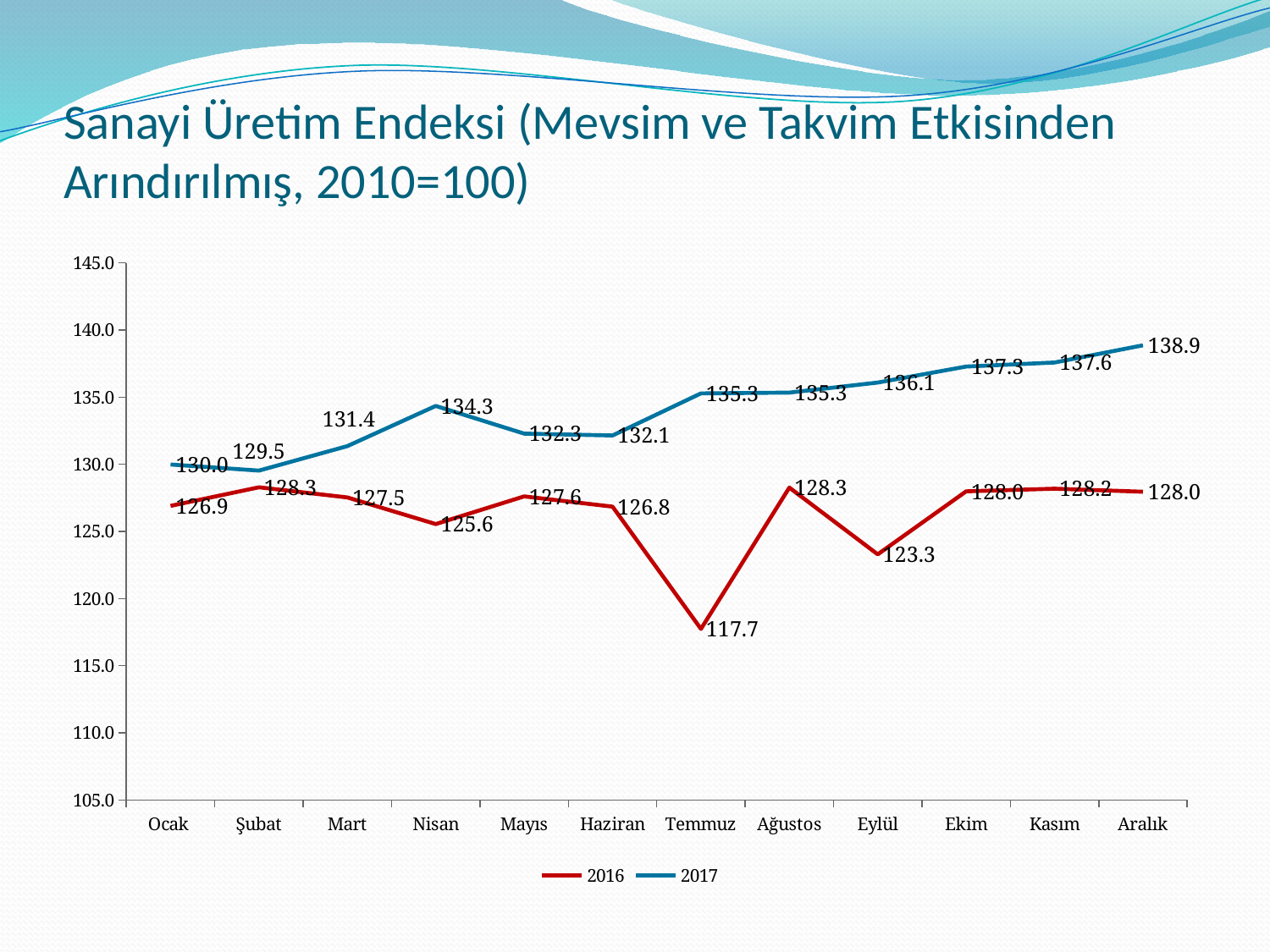
Which month has the highest value for the 2017 series? Aralık Which is larger in Eylül, the 2016 value or the 2017 value? 2017 What is the value for 2017 in Nisan? 134.3 Which series is drawn in red? 2016 Does the 2017 series generally rise or fall from Ocak to Aralık? rise How many series does the legend list? 2 What is the value for 2017 in Aralık? 138.9 Which month has the lowest value for the 2016 series? Temmuz What type of chart is shown on the slide? line chart How many months are shown on the x axis? 12 What is the difference between the 2017 and 2016 values in Aralık? 10.9 What is the value for 2016 in Temmuz? 117.7